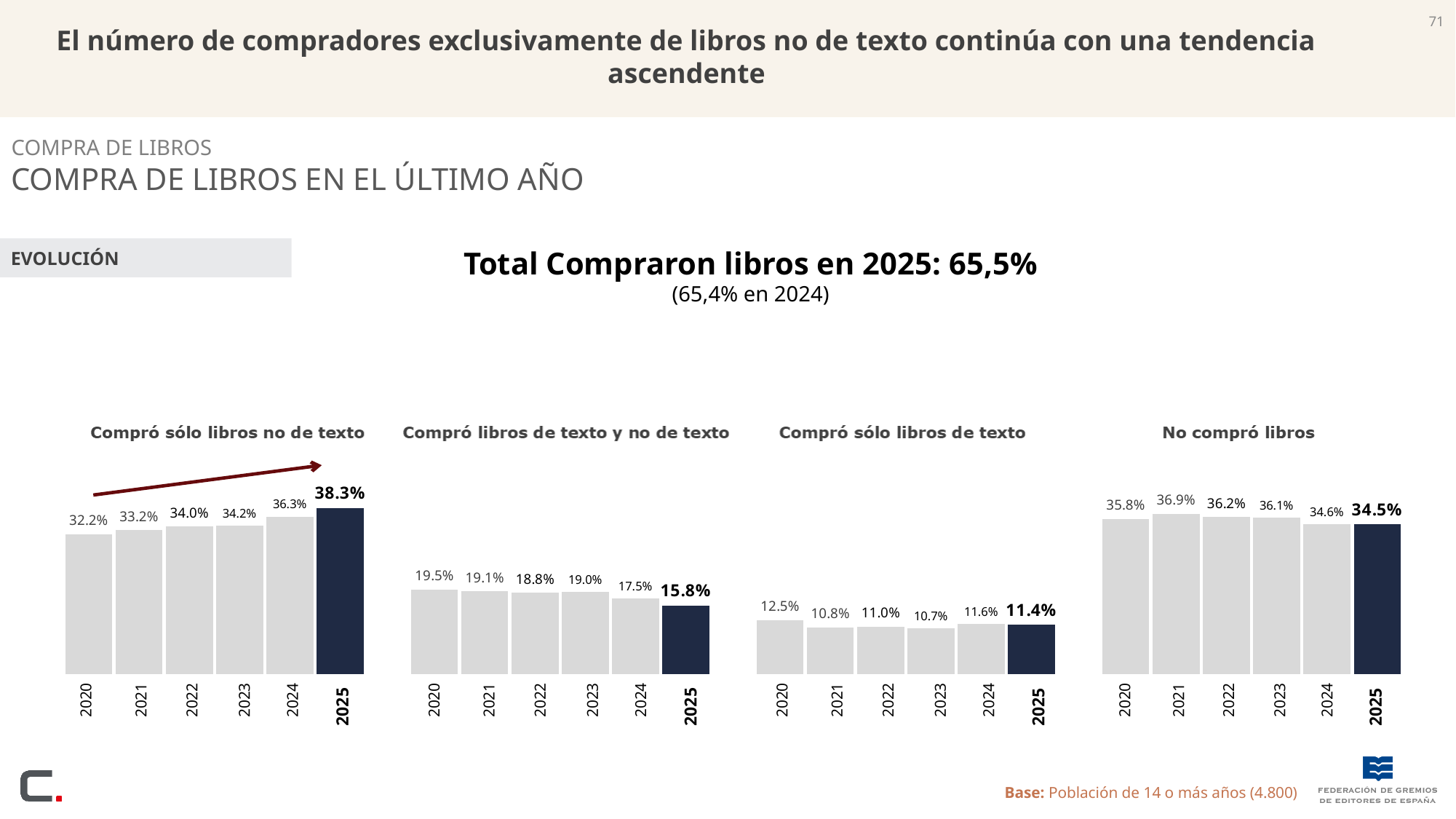
How many years are shown in the 'Compró sólo libros de texto' chart? 6 In the 'Compró libros de texto y no de texto' chart, is the value for 2020 or 2025 larger? 2020 In the 'Compró libros de texto y no de texto' chart, do the values generally rise or fall from 2020 to 2025? Fall In the 'No compró libros' chart, which year has the highest value? 2021 In the 'Compró sólo libros de texto' chart, what is the difference between the 2020 and 2021 values? 1.7% In the 'No compró libros' chart, what is the value for 2024? 34.6% In the 'Compró sólo libros de texto' chart, what is the value for 2023? 10.7% What kind of chart is the 'No compró libros' chart? Bar chart In the 'Compró libros de texto y no de texto' chart, what is the value for 2020? 19.5% In the 'Compró sólo libros no de texto' chart, what is the difference between the 2025 and 2024 values? 2.0% In the 'Compró sólo libros no de texto' chart, what is the value for 2025? 38.3% In the 'Compró sólo libros no de texto' chart, which year has the lowest value? 2020